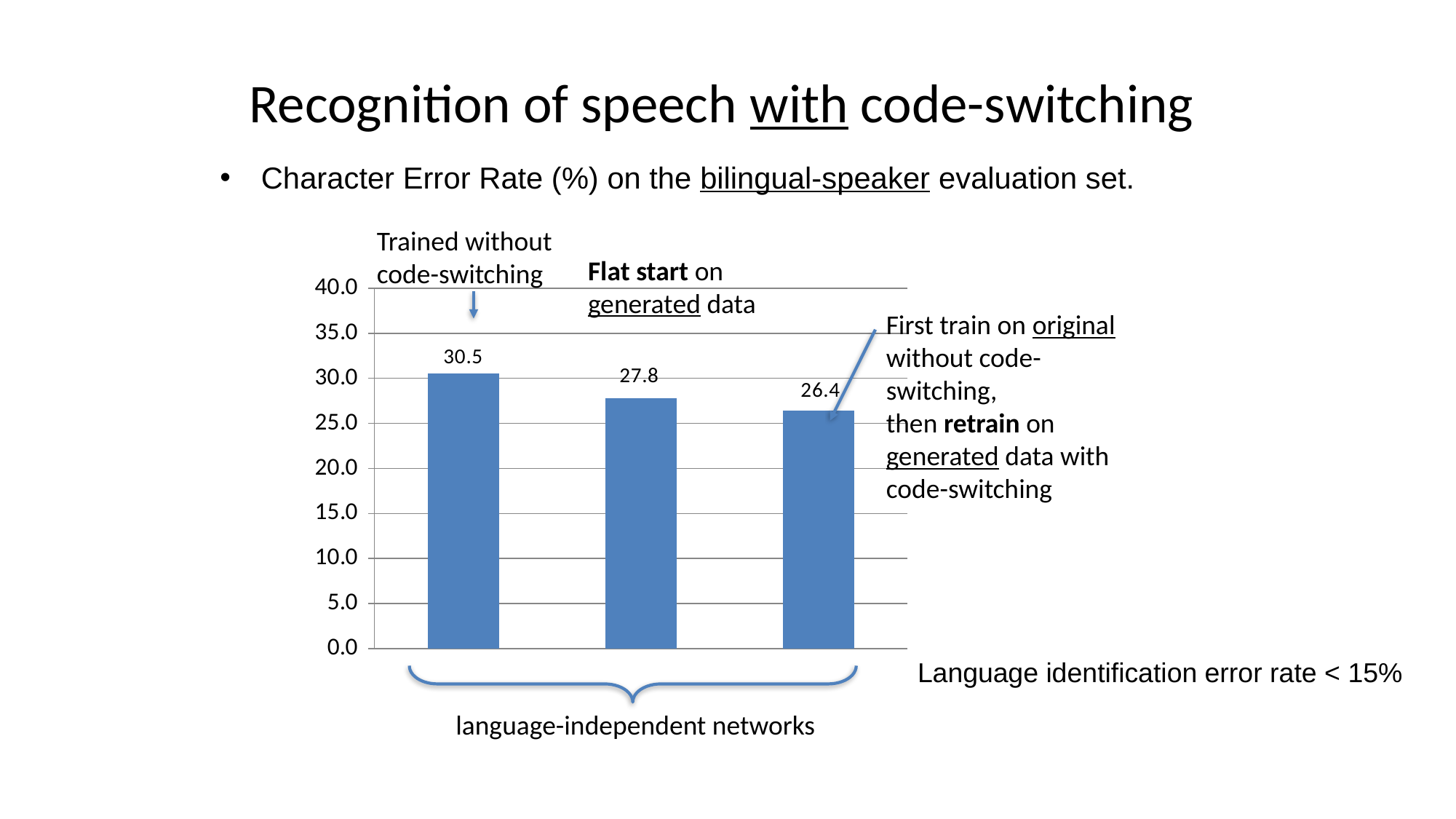
Do the Character Error Rate values rise or fall from the first bar to the third bar? Fall What is the Character Error Rate for the flat start on generated data (the middle bar)? 27.8 Which is larger, the Character Error Rate for the flat start on generated data or for the retrained network? Flat start on generated data Which bar has the lowest Character Error Rate? First train on original, then retrain on generated data with code-switching (third bar) What is the Character Error Rate for the network trained without code-switching (the first bar)? 30.5 How many bars are plotted in the chart? 3 Which bar has the highest Character Error Rate? Trained without code-switching (first bar) What kind of chart is shown on the slide? Bar chart What is the Character Error Rate for the network first trained on original data and then retrained on generated data with code-switching (the third bar)? 26.4 What is the difference between the Character Error Rate of the first bar (30.5) and the third bar (26.4)? 4.1 Is the Character Error Rate for the flat start on generated data greater or less than 30.0? less What is the difference between the Character Error Rate of the first bar and the middle bar (flat start)? 2.7